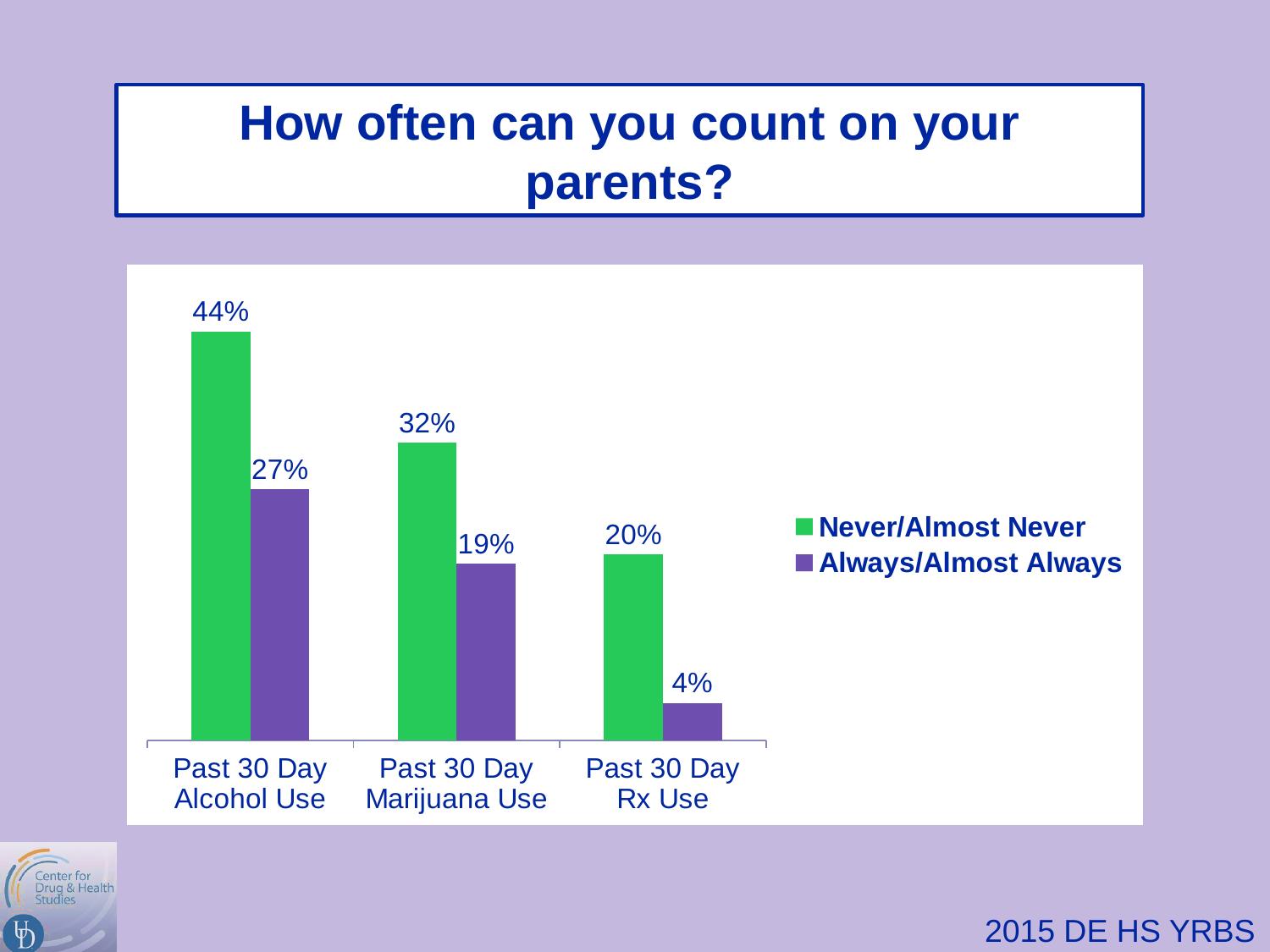
What is the Never/Almost Never value for Past 30 Day Alcohol Use? 44% How many series does the legend list? 2 What is the difference between the Never/Almost Never values for Past 30 Day Marijuana Use and Past 30 Day Rx Use? 12% Which category has the lowest Always/Almost Always value? Past 30 Day Rx Use Which is larger: the Always/Almost Always value for Past 30 Day Alcohol Use or the Never/Almost Never value for Past 30 Day Rx Use? Always/Almost Always for Past 30 Day Alcohol Use What kind of chart is shown on the slide? Bar chart Which category has the highest Never/Almost Never value? Past 30 Day Alcohol Use How many categories are shown on the x axis? 3 What is the Always/Almost Always value for Past 30 Day Rx Use? 4% What is the Never/Almost Never value for Past 30 Day Rx Use? 20% What is the Always/Almost Always value for Past 30 Day Marijuana Use? 19% What is the difference between the Never/Almost Never and Always/Almost Always values for Past 30 Day Alcohol Use? 17%